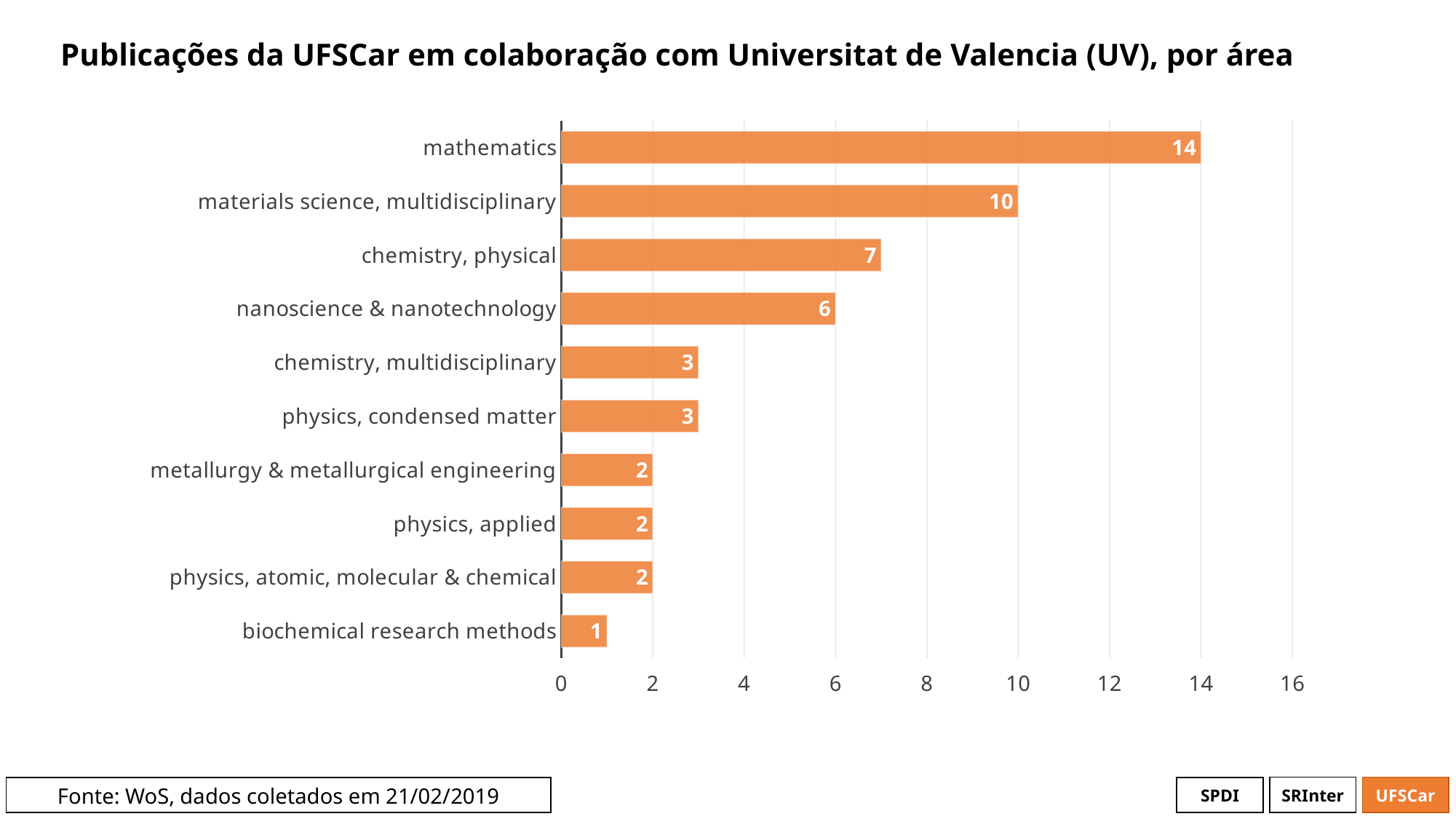
What kind of chart is shown on the slide? bar chart How many categories are shown in the chart? 10 Which is larger, the value for chemistry, physical or the value for chemistry, multidisciplinary? chemistry, physical What is the value for nanoscience & nanotechnology? 6 What is the value for biochemical research methods? 1 Which category has the lowest value? biochemical research methods What is the value for materials science, multidisciplinary? 10 What is the difference between the values for mathematics and materials science, multidisciplinary? 4 What is the difference between the values for chemistry, physical and nanoscience & nanotechnology? 1 What is the value for mathematics? 14 What is the title of the chart? Publicações da UFSCar em colaboração com Universitat de Valencia (UV), por área Which category has the highest value? mathematics